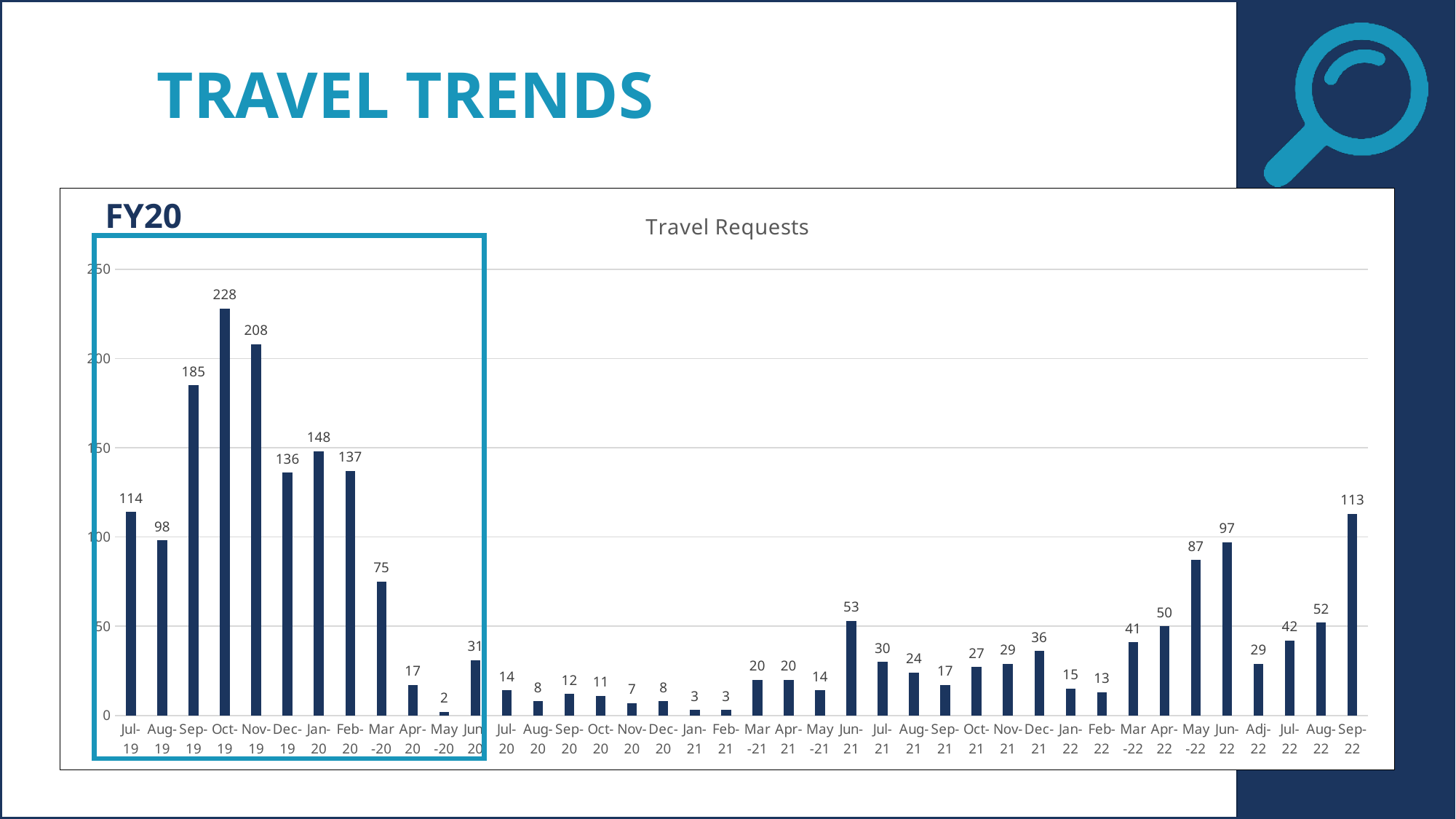
What is the value for Sep-22? 113 Which month has the highest number of travel requests? Oct-19 Which is larger, the value for May-22 or the value for Jun-22? Jun-22 What is the value for Jun-21? 53 What is the value for Oct-19? 228 Which month has the lowest number of travel requests? May-20 What is the title of the chart? Travel Requests What is the value for May-20? 2 Which fiscal year is highlighted with a box on the chart? FY20 Is the value for Sep-19 greater or less than 150? greater What kind of chart is shown on the slide? bar chart What is the difference between the values for Oct-19 and Nov-19? 20